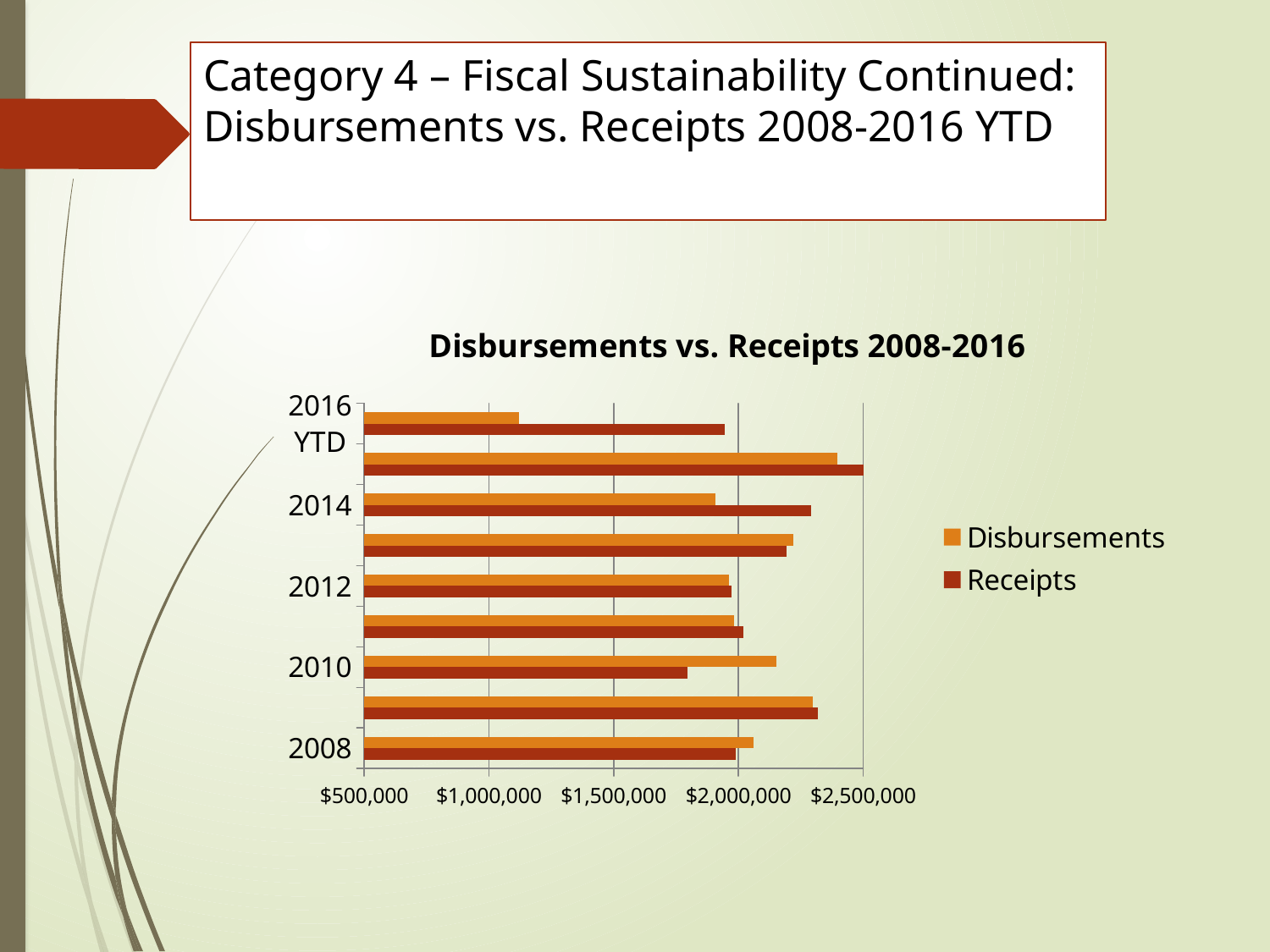
Is the Receipts value for 2010 greater or less than $2,000,000? less Is the Receipts value for 2014 greater or less than $2,000,000? greater How many years (categories) are plotted on the chart? 9 For 2010, which is larger, Disbursements or Receipts? Disbursements Which year has the lowest Disbursements value? 2016 YTD How many series does the legend list? 2 Which year has the highest Receipts value? 2015 Is the Disbursements value for 2016 YTD greater or less than $1,500,000? less For 2016 YTD, which is larger, Disbursements or Receipts? Receipts What kind of chart is shown on the slide? bar chart